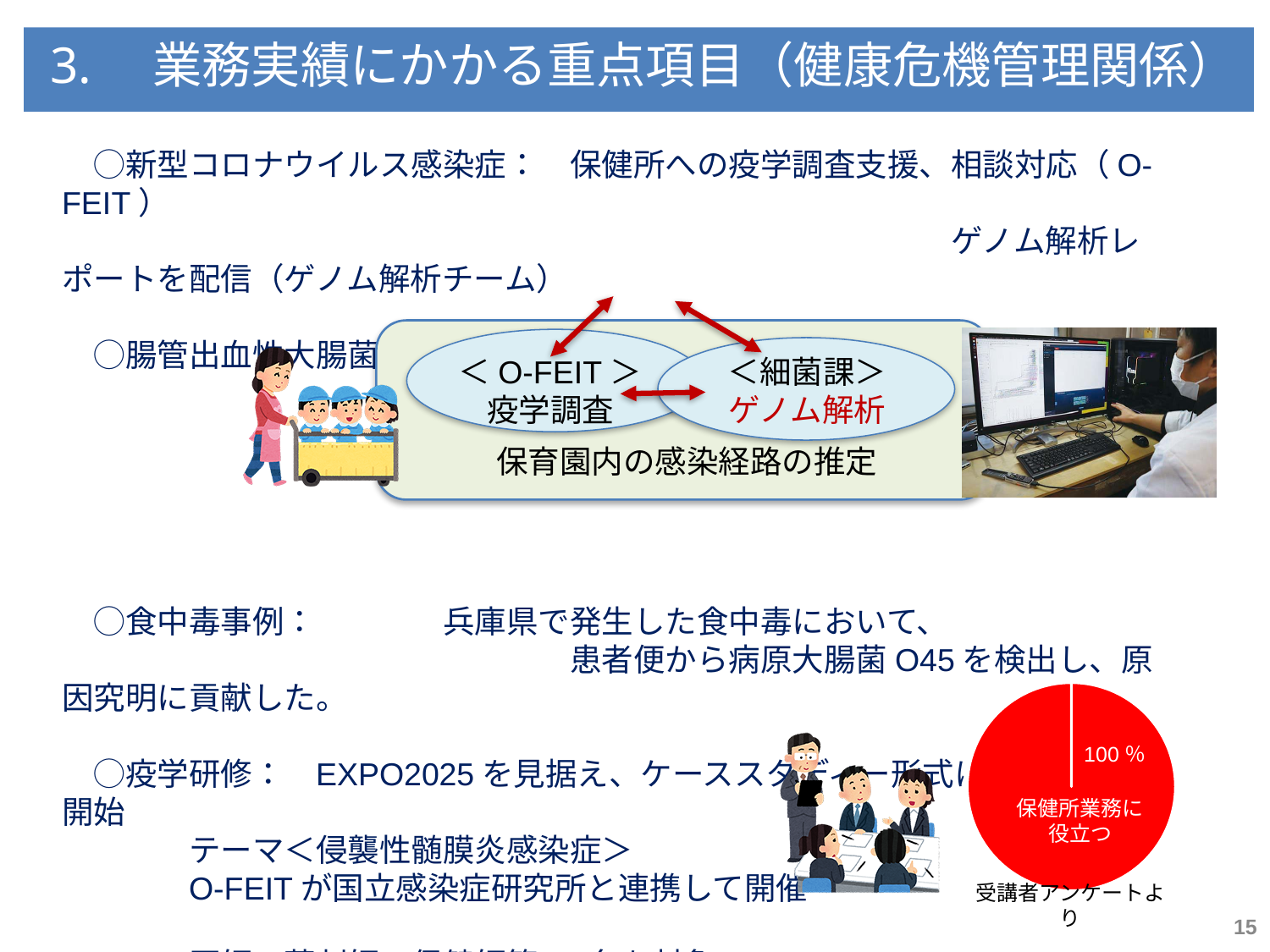
In the pie chart at the bottom right, what percentage is shown for 「保健所業務に役立つ」? 100 % What is the label of the only slice in the pie chart at the bottom right? 保健所業務に役立つ What colour is the slice in the pie chart at the bottom right of the slide? red How many slices does the pie chart at the bottom right of the slide have? 1 What kind of chart is shown at the bottom right of the slide? pie chart What caption is written below the pie chart at the bottom right of the slide? 受講者アンケートより In the pie chart at the bottom right, what share of the pie does the 「保健所業務に役立つ」 slice take? 100 %